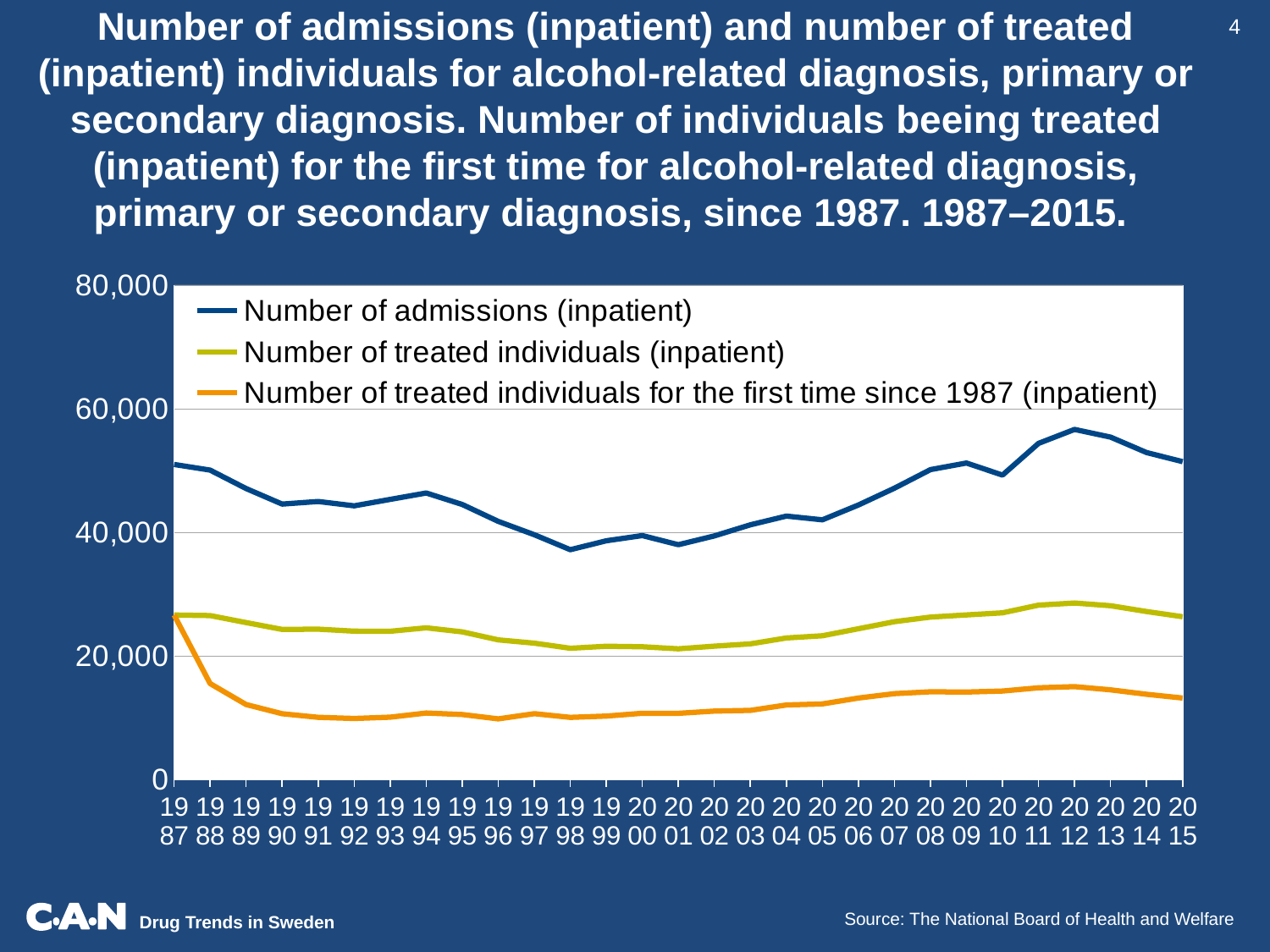
How many years are plotted along the x axis? 29 What kind of chart is shown on the slide? line chart Is the value for Number of treated individuals for the first time since 1987 (inpatient) in 1991 greater or less than 20,000? less Is the value for Number of admissions (inpatient) in 2012 greater or less than 40,000? greater What is the source cited for the chart? The National Board of Health and Welfare Which series is plotted with the orange line? Number of treated individuals for the first time since 1987 (inpatient) In 2015, which is larger: Number of admissions (inpatient) or Number of treated individuals (inpatient)? Number of admissions (inpatient) Does the Number of treated individuals for the first time since 1987 (inpatient) rise or fall between 1987 and 1990? fall How many series does the legend list? 3 Is the value for Number of treated individuals (inpatient) in 1987 greater or less than 20,000? greater In which year does Number of admissions (inpatient) reach its highest value? 2012